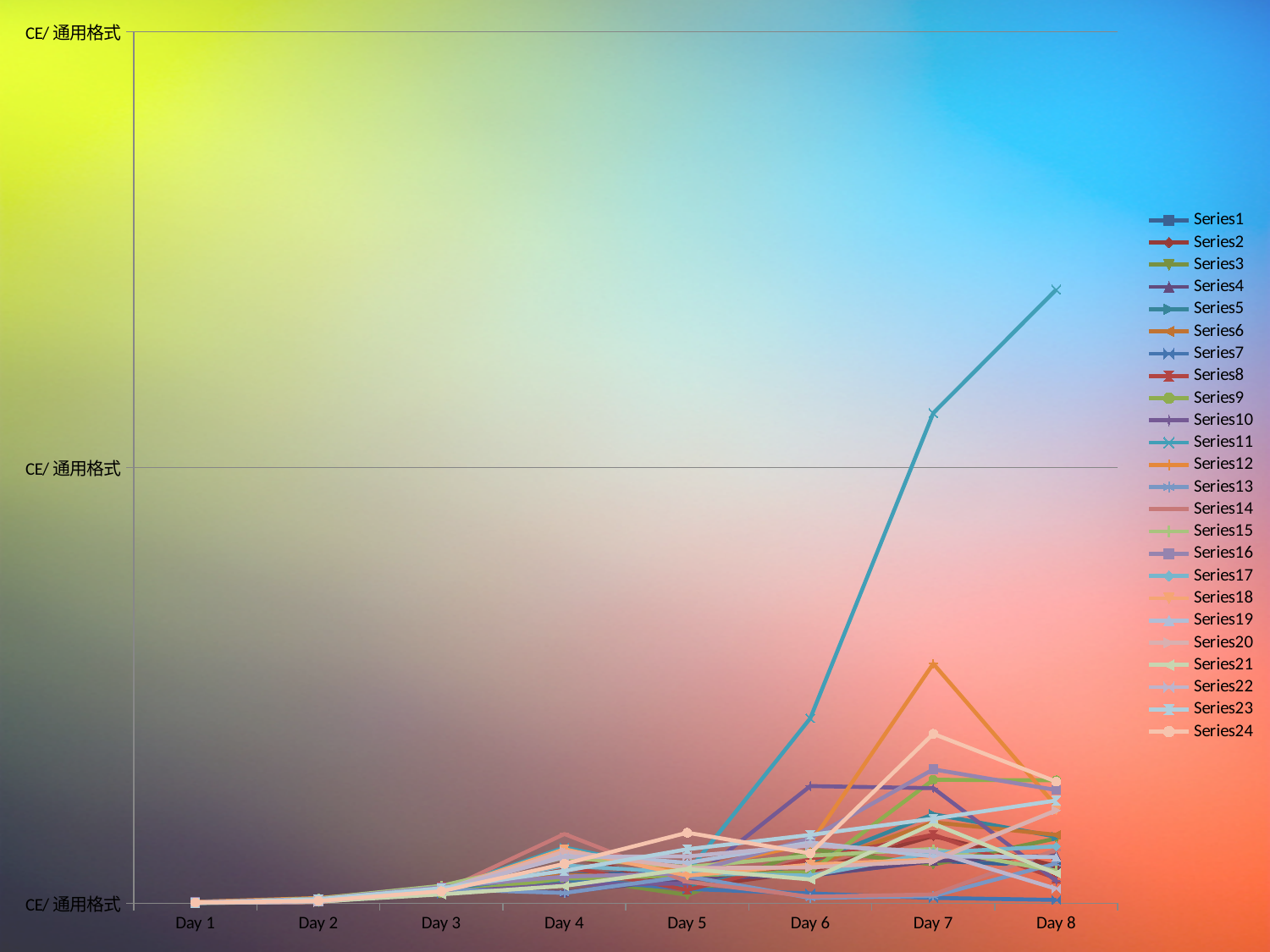
How many categories are shown along the x axis? 8 Which series reaches the highest value on the chart? Series11 What is the last entry listed in the legend? Series24 How many series does the legend list? 24 Which series has the highest value at Day 8? Series11 Which is larger at Day 7, the value for Series11 or the value for Series1? Series11 What is the first category label on the x axis? Day 1 Does Series11 rise or fall from Day 5 to Day 8? Rise Which series has the highest value at Day 7? Series11 Which is larger at Day 8, the value for Series11 or the value for Series12? Series11 What kind of chart is shown on the slide? Line chart